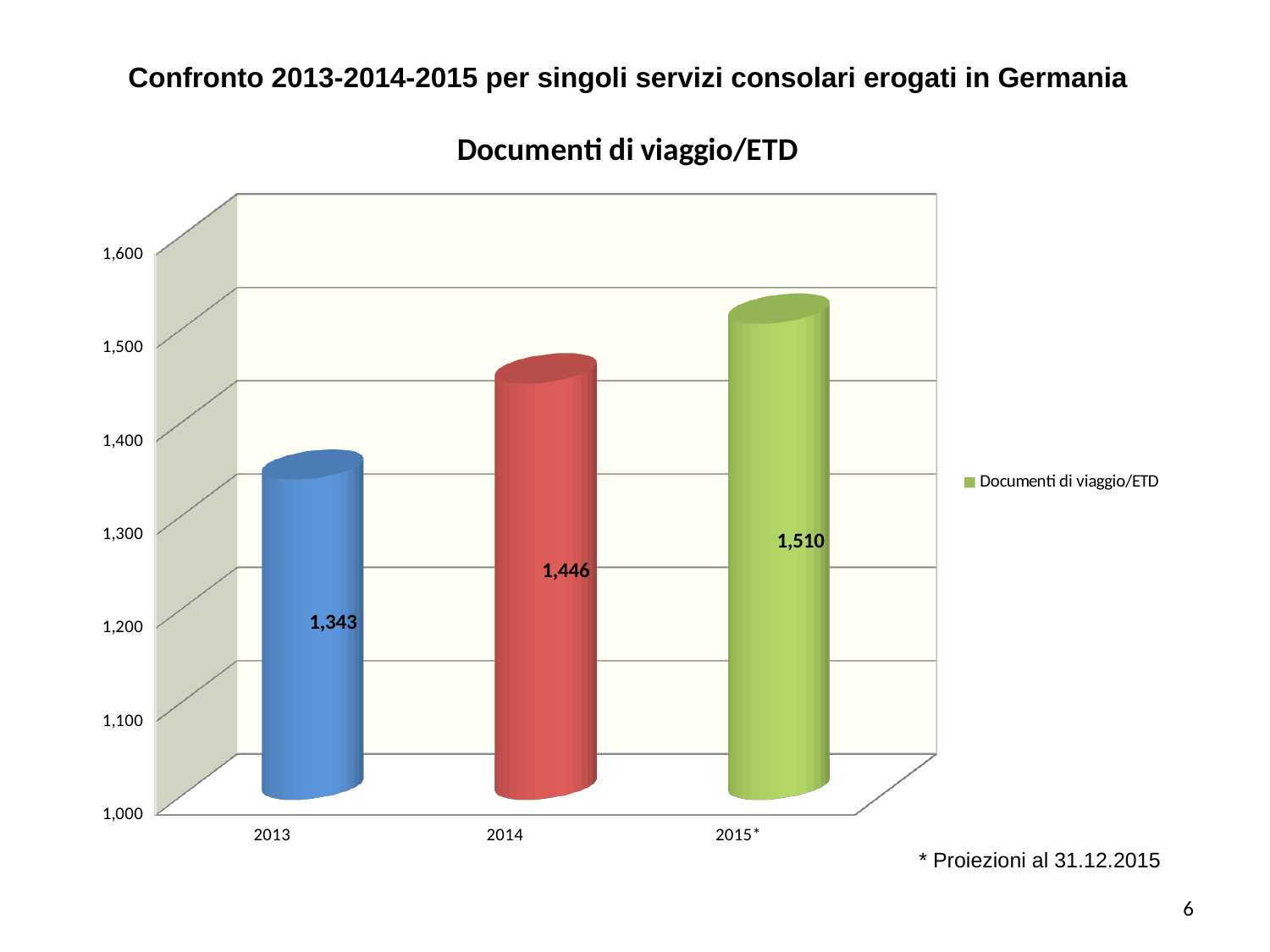
What is the value for 2013? 1,343 Which year has the highest value? 2015* What kind of chart is shown? bar chart What is the value for 2015*? 1,510 Which year has the lowest value? 2013 What is the difference between the values for 2015* and 2013? 167 Do the values rise or fall from 2013 to 2015*? rise How many years are shown on the x axis? 3 What is the difference between the values for 2014 and 2013? 103 Which is larger, the value for 2014 or the value for 2015*? 2015* Is the value for 2014 greater or less than 1,400? greater What is the value for 2014? 1,446